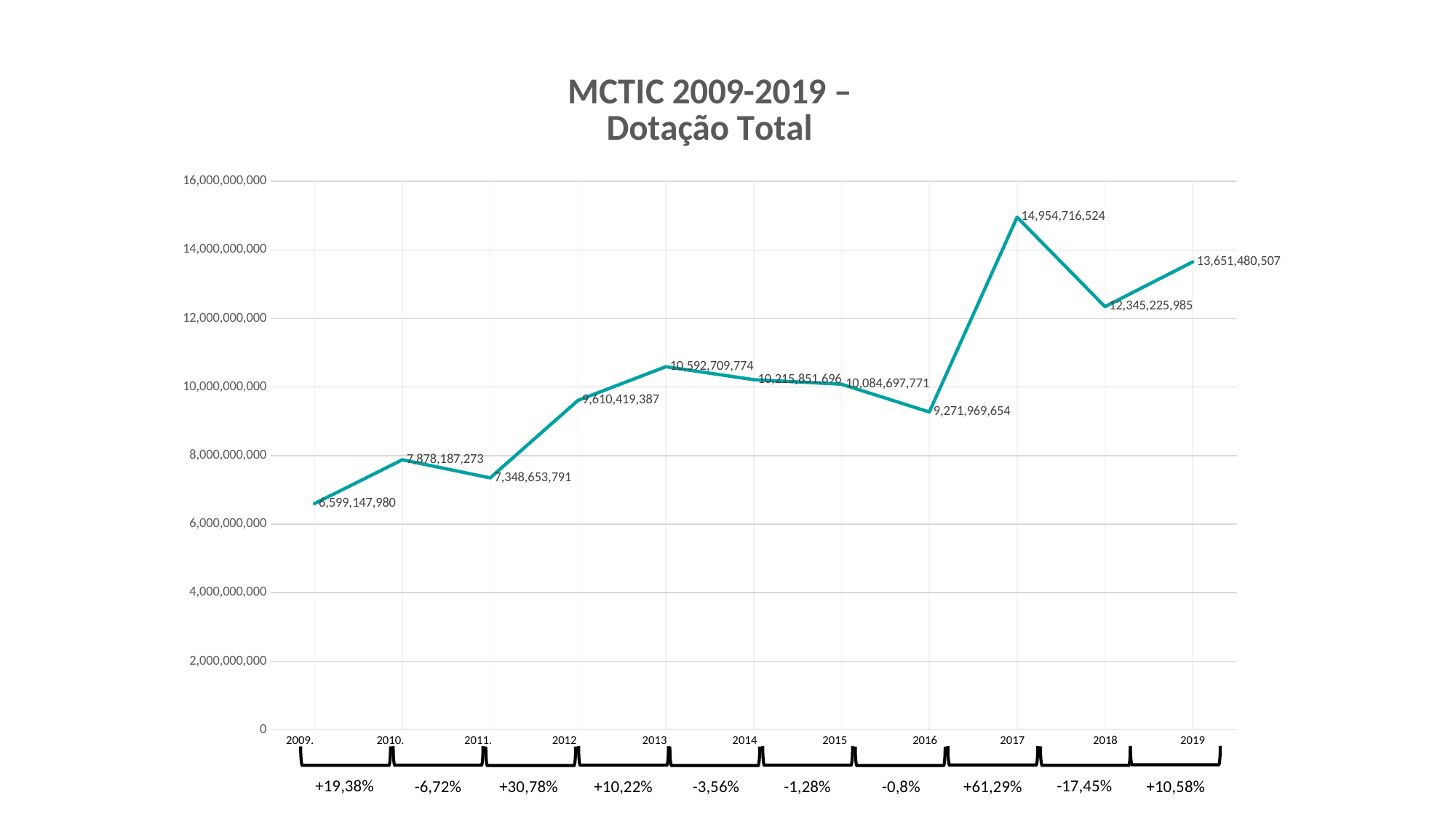
Which year has the lowest value? 2009 Is the value for 2018 greater or less than 12,000,000,000? greater How many years are plotted on the chart? 11 Which is larger, the value for 2010 or the value for 2011? 2010 What kind of chart is shown? line chart Which year has the highest value? 2017 What is the difference between the values for 2019 and 2018? 1,306,254,522 What percentage change is shown between 2016 and 2017 below the chart? +61,29% What is the value for 2009? 6,599,147,980 What is the value for 2017? 14,954,716,524 What is the value for 2013? 10,592,709,774 What is the difference between the values for 2017 and 2016? 5,682,746,870